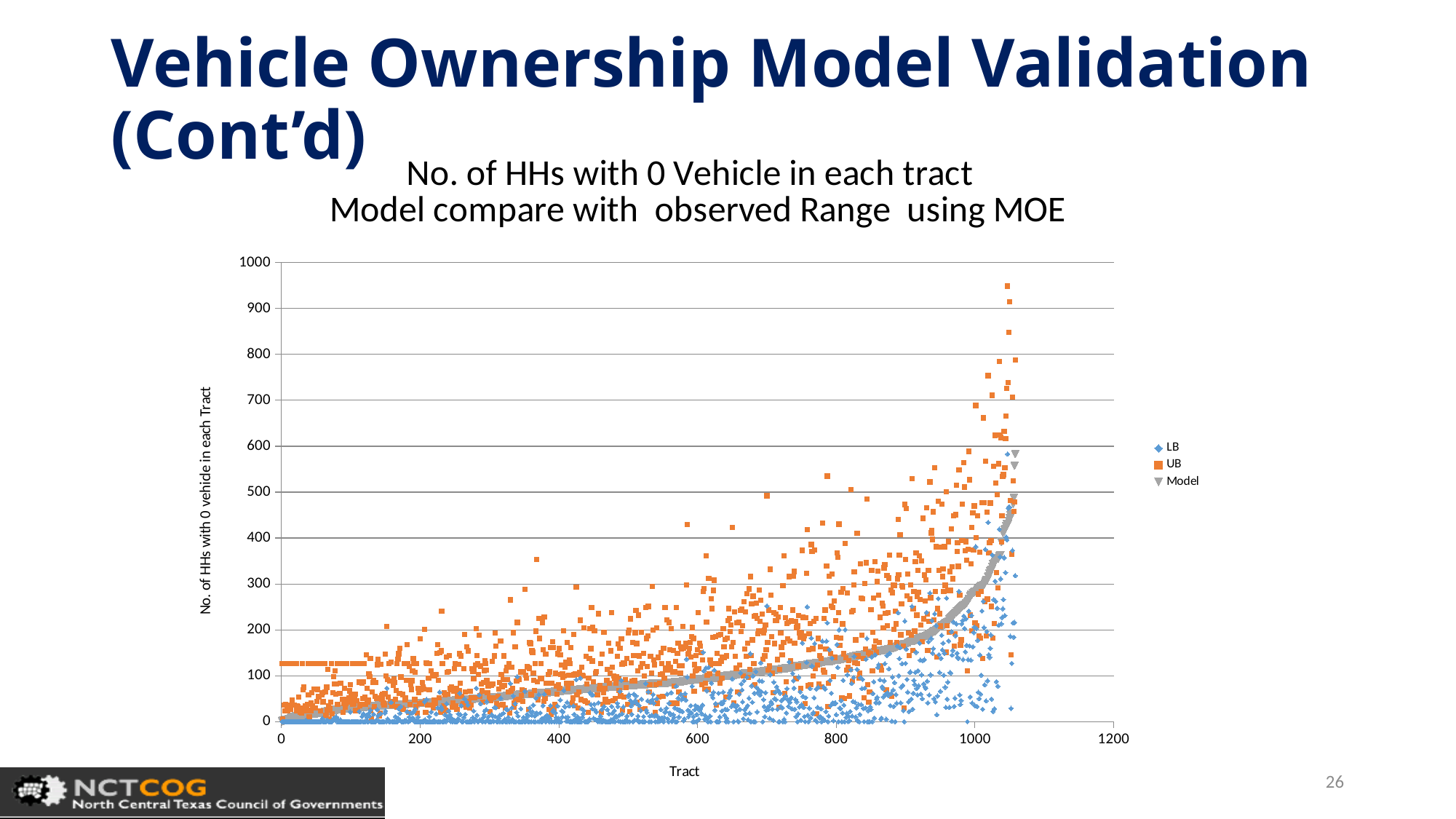
Is the highest UB point on the chart greater or less than 900? greater What is the title of the chart? No. of HHs with 0 Vehicle in each tract Model compare with observed Range using MOE Is the Model value at tract 1000 greater or less than 200? greater Which series reaches the highest value on the chart, LB or UB? UB How many series does the chart's legend list? 3 Does the Model series rise or fall as the tract number increases along the x axis? Rise Is the highest LB point on the chart greater or less than 600? less What are the names of the series listed in the chart's legend? LB, UB, Model What is the maximum value shown on the chart's y axis? 1000 What kind of chart is shown on the slide? Scatter chart